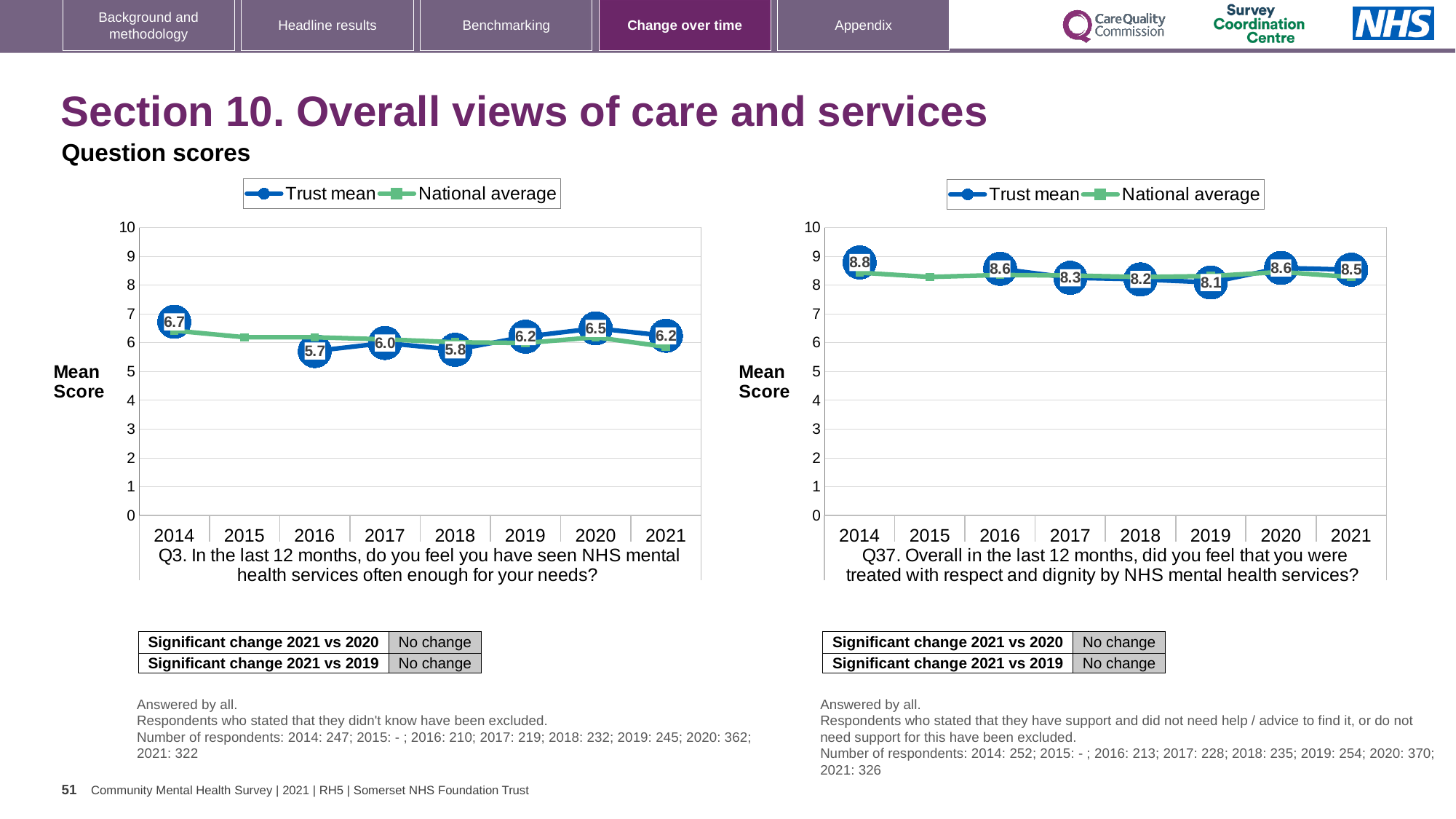
In the Q3 chart on the left, what is the Trust mean for 2014? 6.7 In the Q37 chart on the right, which year has the highest Trust mean? 2014 In the Q3 chart on the left, is the Trust mean for 2021 greater or less than 5? greater What type of chart is used for the Q3 question on the left? Line chart In the Q3 chart on the left, which year has the lowest Trust mean? 2016 In the Q37 chart on the right, how many years are shown on the x axis? 8 In the Q37 chart on the right, how many series does the legend list? 2 In the Q3 chart on the left, what is the difference between the Trust mean in 2014 and in 2016? 1.0 In the Q37 chart on the right, what is the Trust mean for 2019? 8.1 In the Q3 chart on the left, what is the Trust mean for 2020? 6.5 In the Q37 chart on the right, is the Trust mean higher in 2020 or in 2017? 2020 In the Q37 chart on the right, what is the difference between the Trust mean in 2014 and in 2021? 0.3